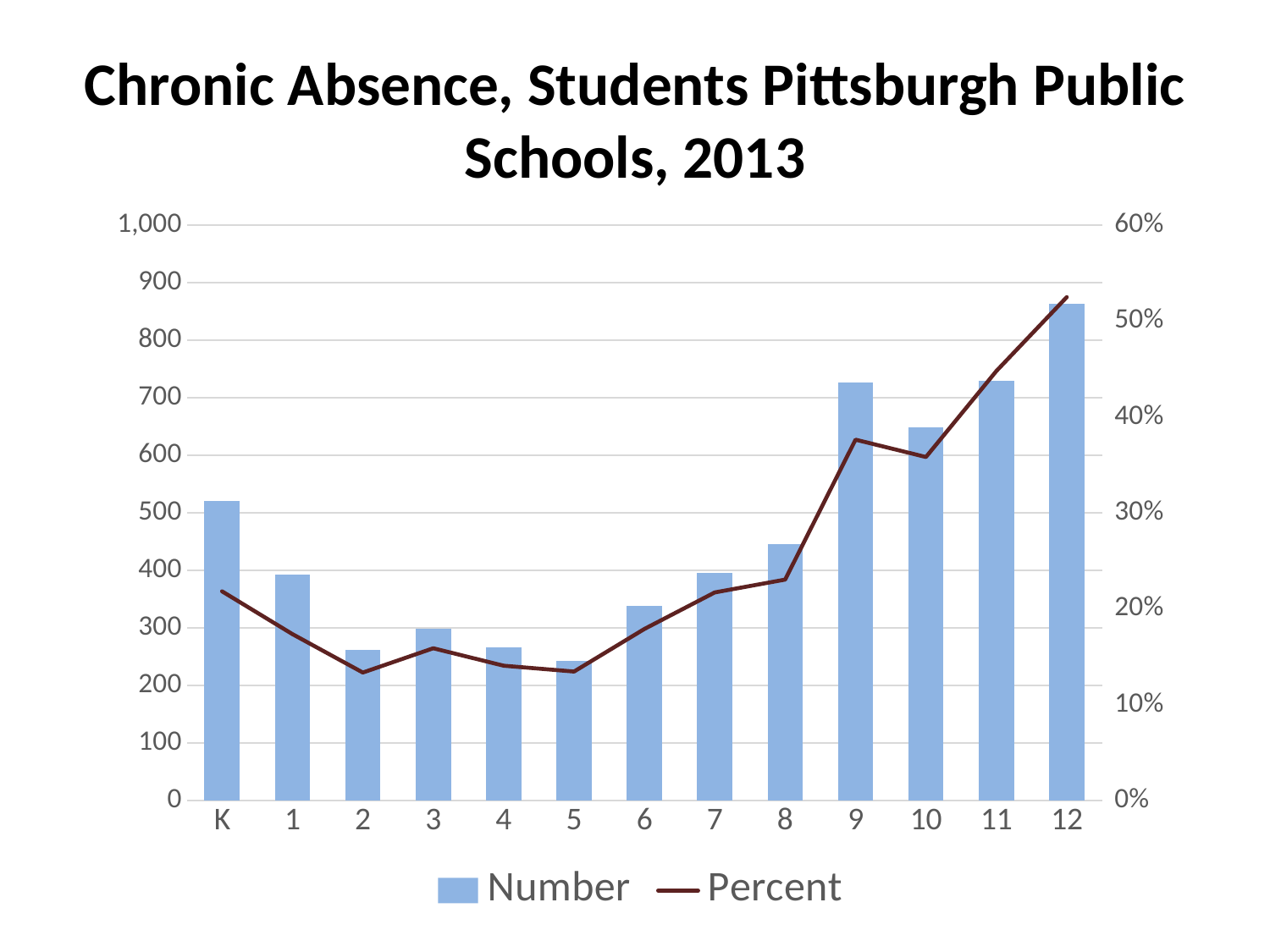
Is the Number value for grade 9 greater or less than 700? greater Is the Number value for grade 8 greater or less than 500? less Is the Percent value for grade 12 greater or less than 50%? greater How many series does the legend list? 2 Which grade has the highest Number of chronically absent students? 12 What is the title of the chart? Chronic Absence, Students Pittsburgh Public Schools, 2013 How many grade categories are shown on the x axis? 13 Which series is drawn as a line rather than bars? Percent Which has a larger Number value, grade 9 or grade 10? grade 9 Does the Percent line rise or fall from grade 5 to grade 12? rise